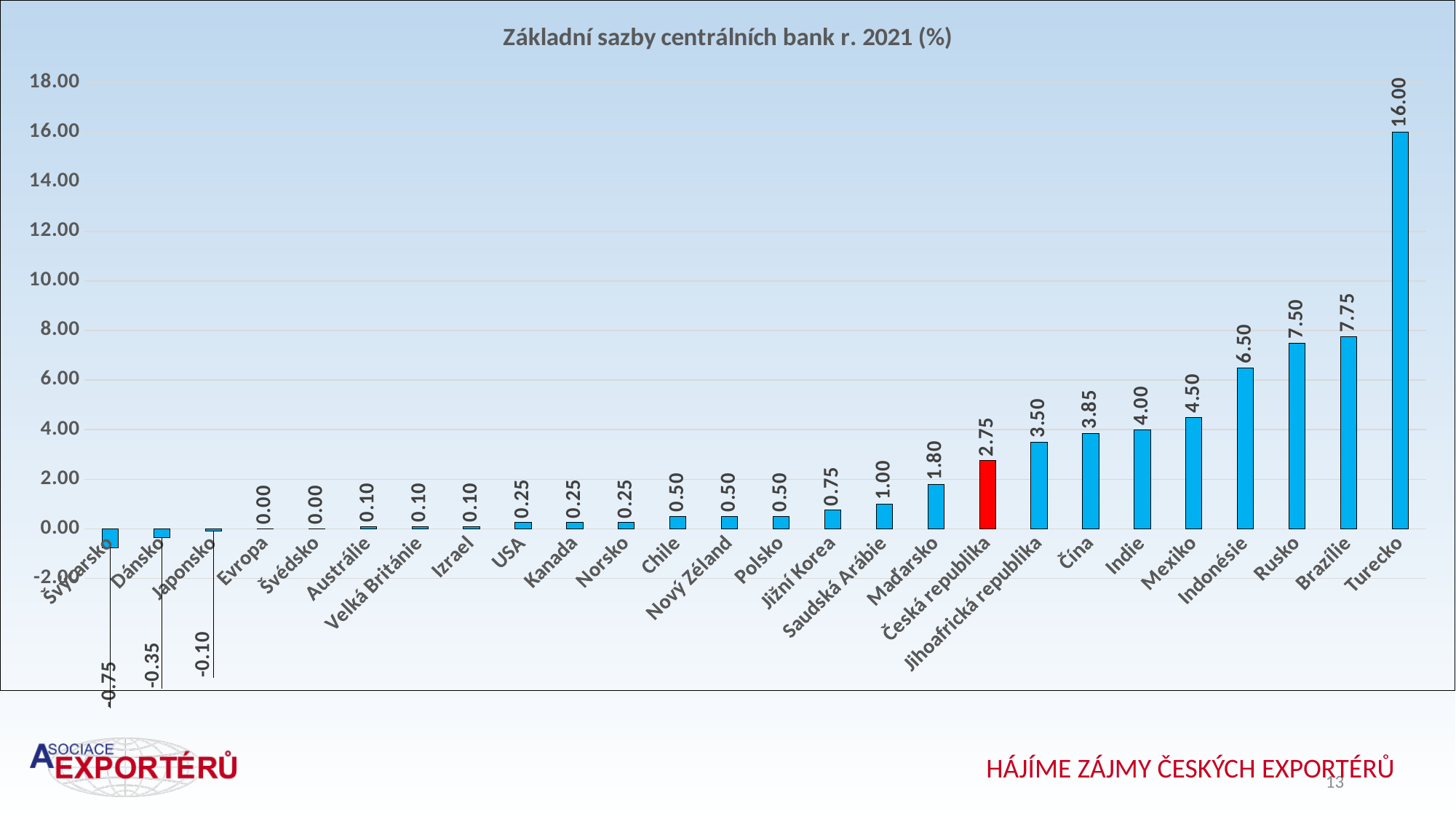
How many countries or regions are shown on the x axis? 26 Which country has the lowest value? Švýcarsko What is the value for Čína? 3.85 What kind of chart is this? Bar chart What is the value for Turecko? 16.00 What is the difference between the values for Turecko and Brazílie? 8.25 Which country has the highest value? Turecko What is the difference between the values for Česká republika and Maďarsko? 0.95 What is the value for Česká republika? 2.75 Which bar is coloured red instead of blue? Česká republika Which is larger, the value for Rusko or the value for Indonésie? Rusko What is the value for Švýcarsko? -0.75